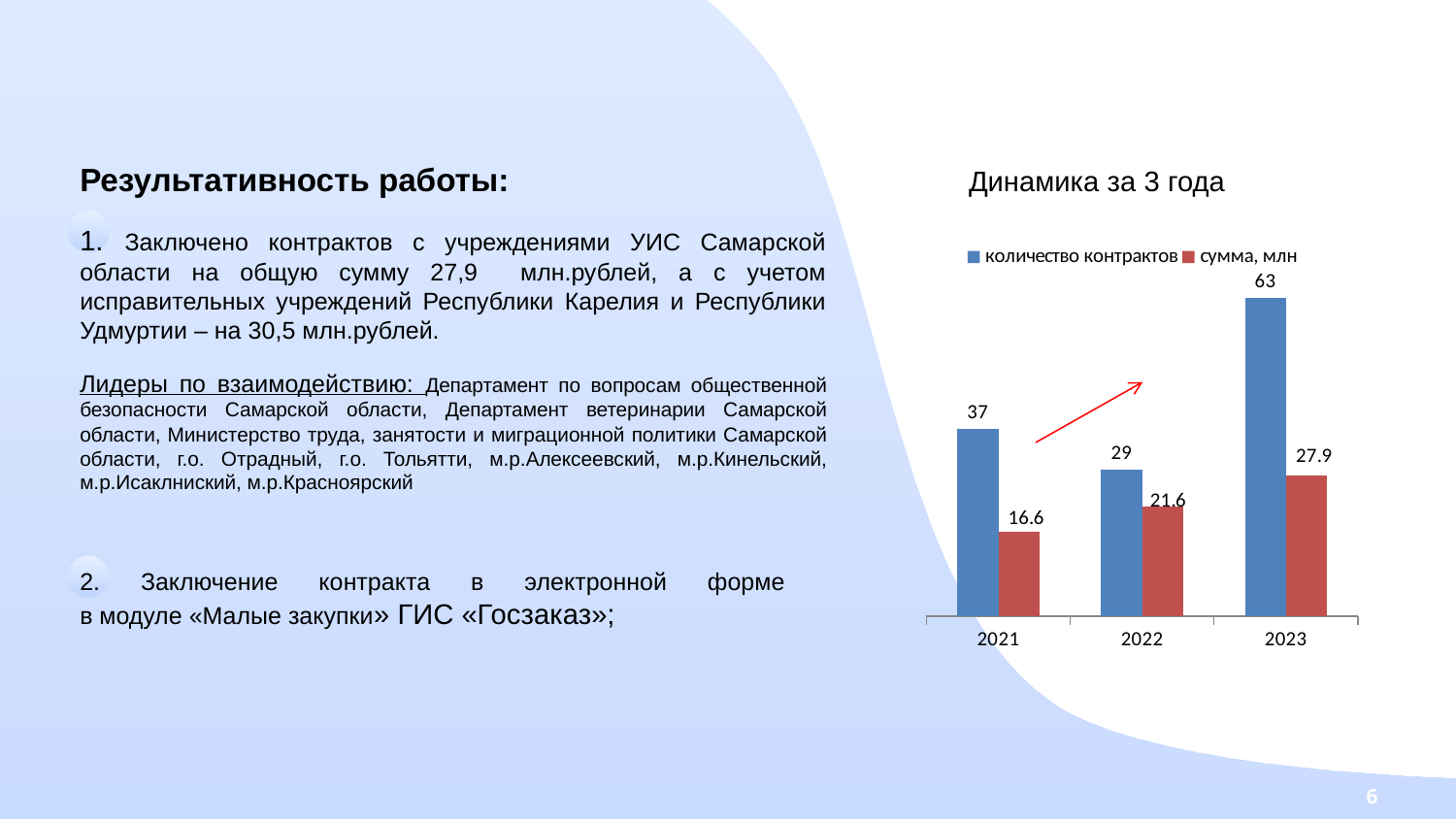
What is the value of 'количество контрактов' for 2023? 63 How many series does the legend list? 2 Does 'количество контрактов' rise or fall from 2021 to 2023? rise What is the value of 'сумма, млн' for 2021? 16.6 What is the value of 'количество контрактов' for 2021? 37 What is the difference between 'количество контрактов' in 2023 and 2022? 34 What kind of chart is shown on the slide? bar chart Which is larger: 'сумма, млн' in 2023 or in 2022? 2023 Which year has the lowest value for 'сумма, млн'? 2021 Which year has the highest value for 'количество контрактов'? 2023 How many years are shown on the x axis? 3 What is the value of 'сумма, млн' for 2022? 21.6